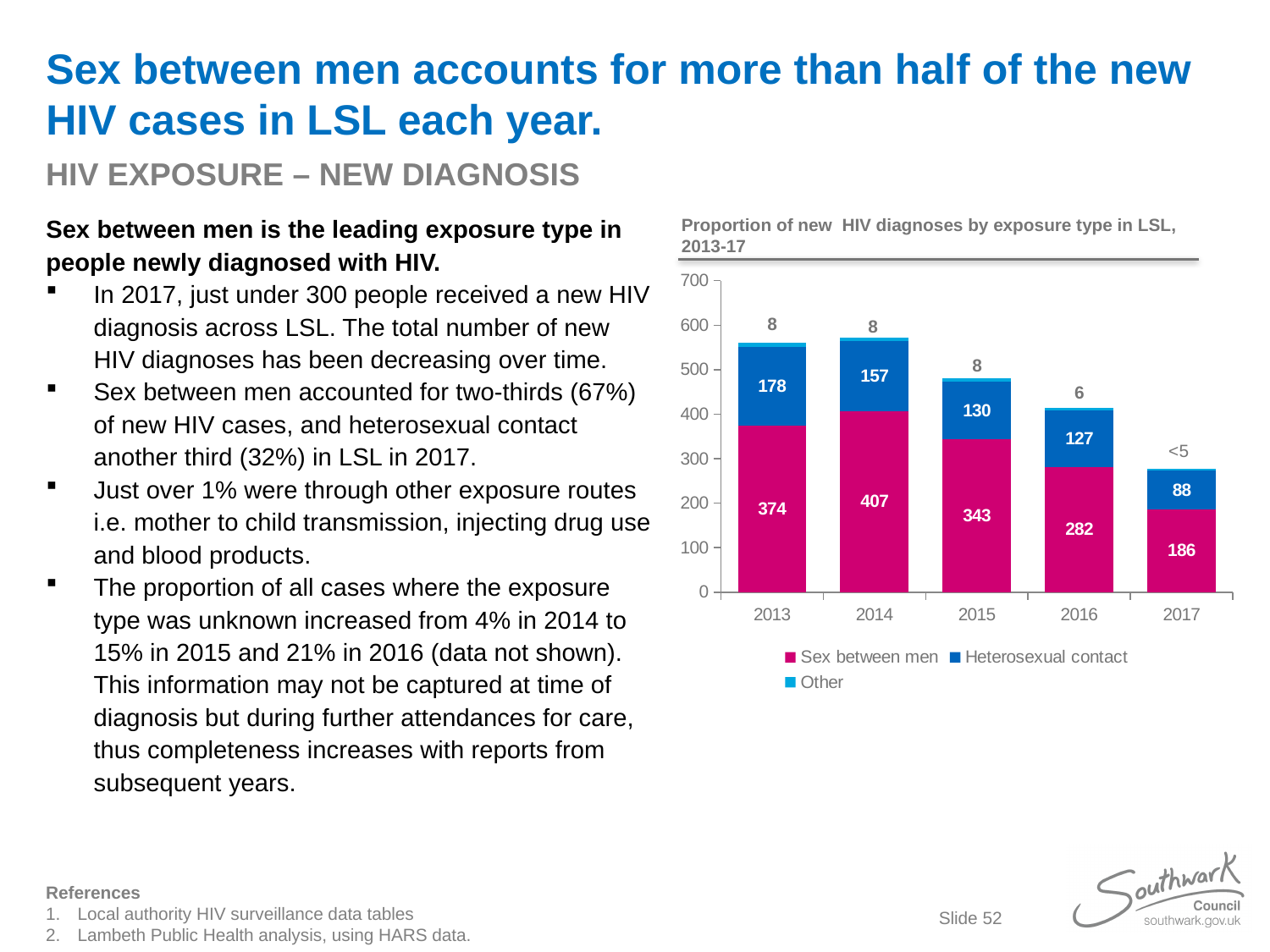
What is the value for Other in 2017? <5 In which year is the value for Heterosexual contact lowest? 2017 What kind of chart is shown? Stacked bar chart How many series does the legend list? 3 In which year is the value for Sex between men highest? 2014 How many years are shown on the x axis? 5 What is the total of the 2013 stacked bar? 560 What is the value for Sex between men in 2014? 407 What is the value for Heterosexual contact in 2016? 127 Which is larger: Heterosexual contact in 2015 or Heterosexual contact in 2016? 2015 Is the total height of the 2017 stacked bar greater or less than 300? less What is the difference between the Sex between men values for 2014 and 2013? 33